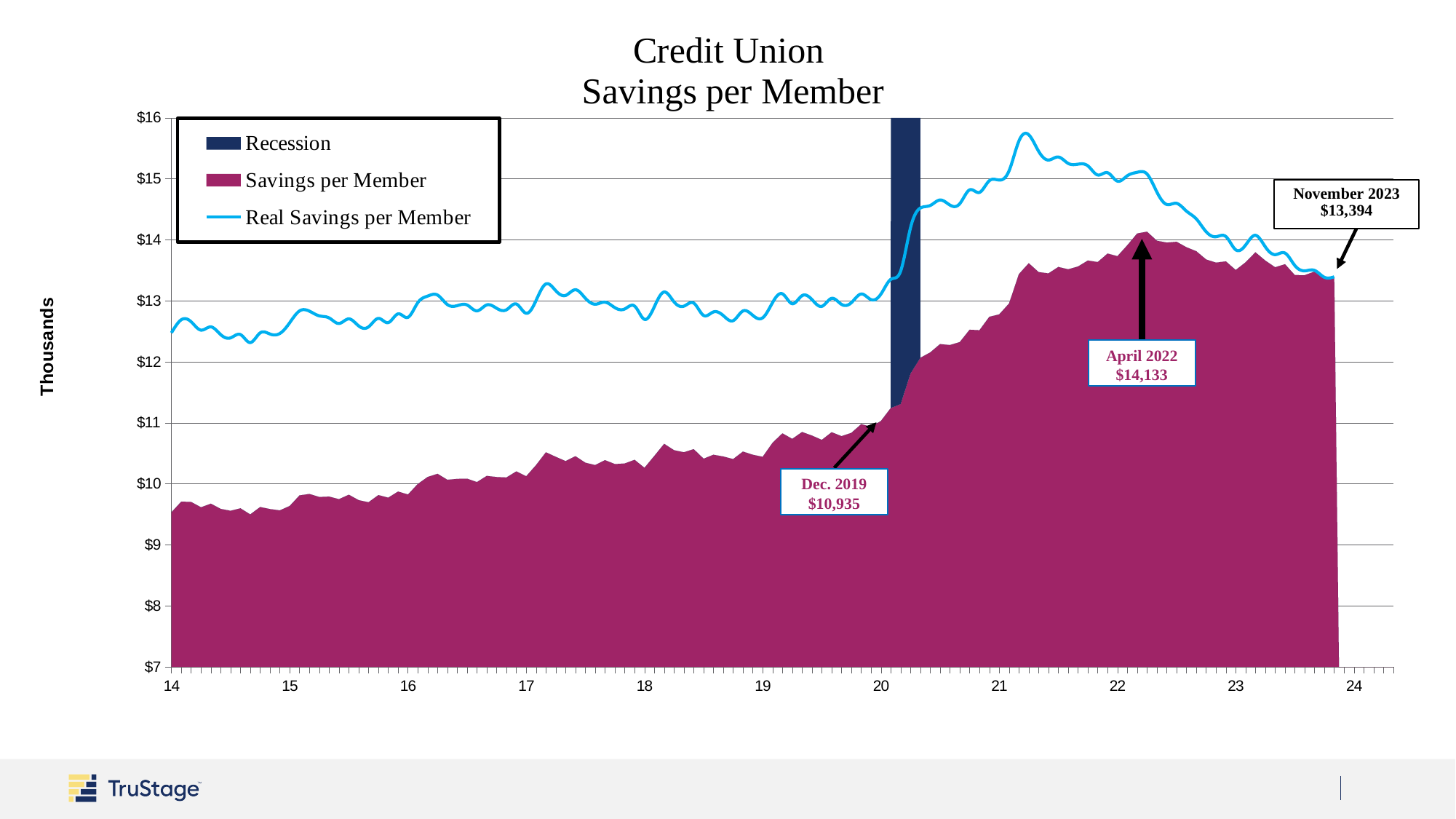
Which is larger, the labelled value for April 2022 or for November 2023? April 2022 How many series does the legend list? 3 By how much did Savings per Member fall from April 2022 to November 2023? $739 What was Savings per Member in November 2023? $13,394 What was Savings per Member in Dec. 2019 according to the annotation? $10,935 What unit is shown on the vertical axis label? Thousands Does Savings per Member rise or fall between 2014 and 2020? rises What value is labelled for April 2022? $14,133 How much higher was Savings per Member in April 2022 than in Dec. 2019? $3,198 At the start of 2014, is Savings per Member greater or less than $10 thousand? less Does Real Savings per Member rise or fall between 2022 and 2023? falls At the start of 2014, is Real Savings per Member greater or less than $12 thousand? greater